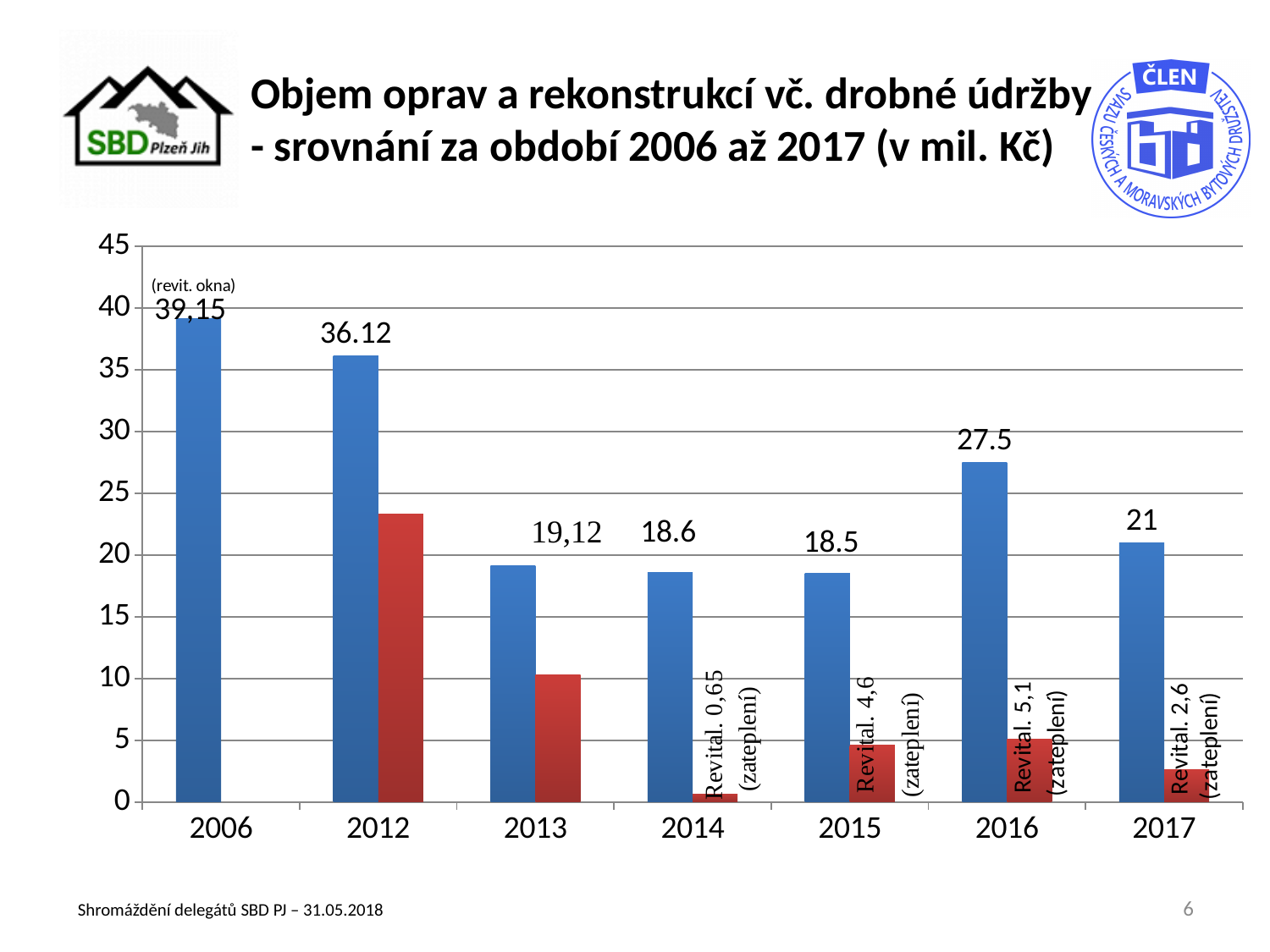
What value is labelled on the red bar for 2015? 4,6 How many years are shown on the x axis? 7 What is the value of the blue bar for 2016? 27.5 Which year has the lowest blue bar? 2015 Do the blue bars rise or fall from 2012 to 2015? fall What kind of chart is shown on the slide? bar chart What is the difference between the blue bar values for 2016 and 2017? 6.5 Which year has the larger blue bar, 2013 or 2016? 2016 Is the value of the red bar for 2012 greater or less than 20? greater What is the value of the blue bar for 2012? 36.12 What is the value of the blue bar for 2006? 39,15 Which year has the highest blue bar? 2006